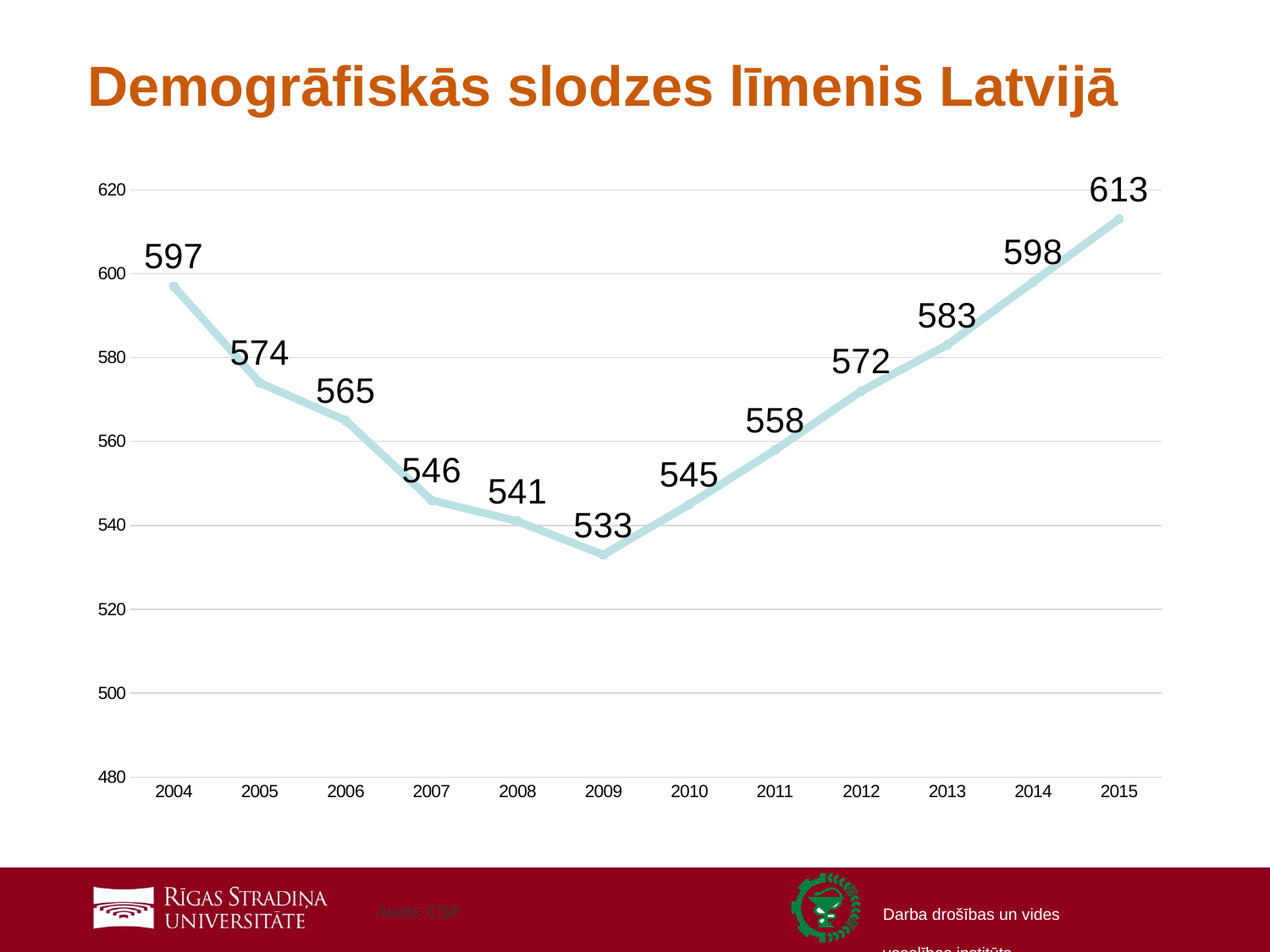
What is the difference between the values for 2004 and 2005? 23 What is the difference between the values for 2015 and 2009? 80 Which year has the highest value? 2015 What is the value for 2015? 613 Do the values rise or fall from 2004 to 2009? fall What is the value for 2009? 533 Which is larger, the value for 2004 or the value for 2014? 2014 How many years are plotted on the chart? 12 Which year has the lowest value? 2009 What kind of chart is shown on the slide? line chart What is the value for 2004? 597 Is the value for 2012 greater or less than 560? greater